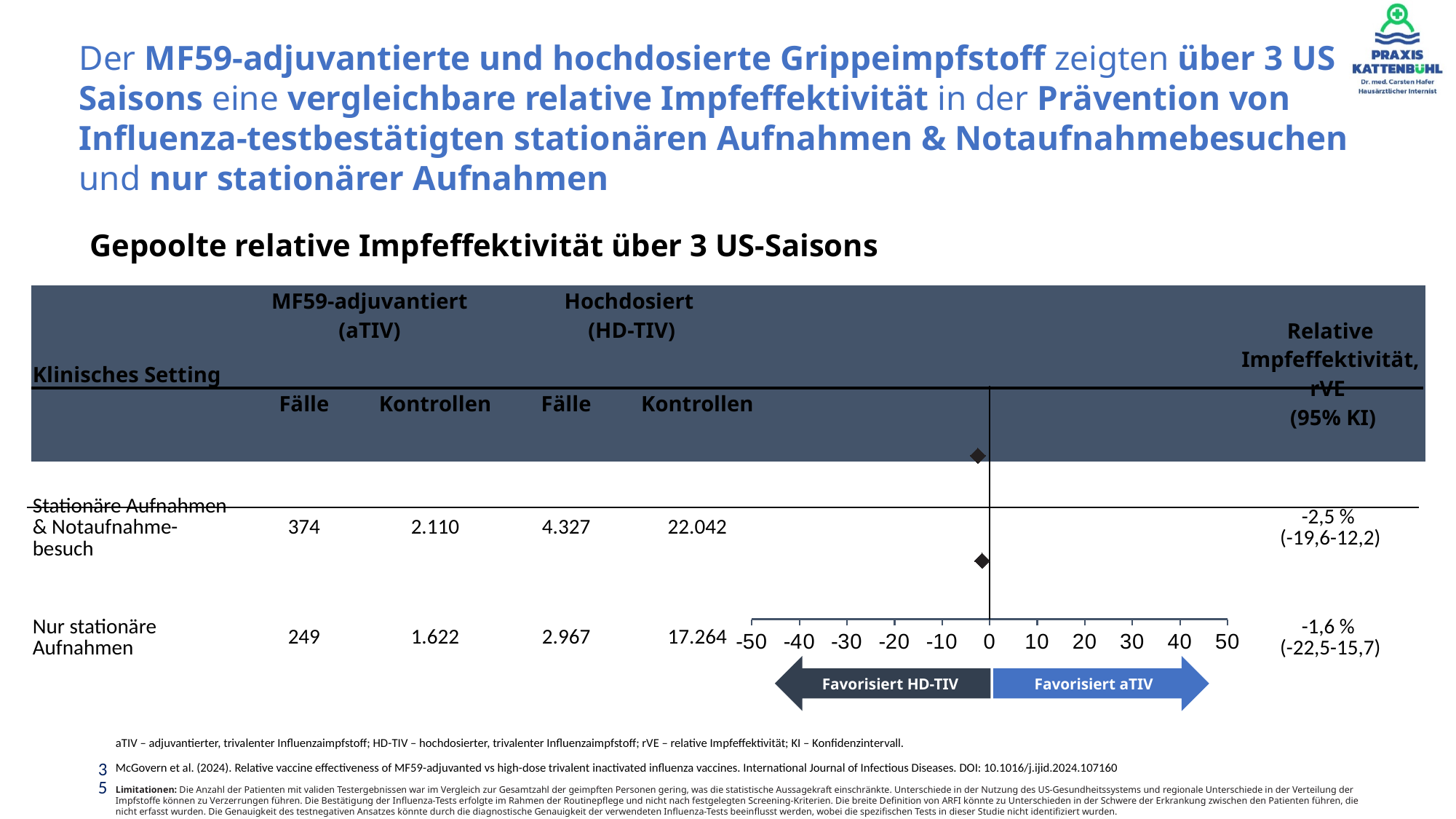
What is the 95% KI printed for 'Stationäre Aufnahmen & Notaufnahmebesuch'? (-19,6-12,2) What is the difference between the rVE values for 'Nur stationäre Aufnahmen' and 'Stationäre Aufnahmen & Notaufnahmebesuch'? 0,9 % Is the rVE value for 'Nur stationäre Aufnahmen' greater or less than 0? less Which rVE value is larger: 'Stationäre Aufnahmen & Notaufnahmebesuch' or 'Nur stationäre Aufnahmen'? Nur stationäre Aufnahmen Which clinical setting has the lower rVE value? Stationäre Aufnahmen & Notaufnahmebesuch What label is shown on the left arrow below the forest plot axis? Favorisiert HD-TIV What is the relative vaccine effectiveness (rVE) shown for 'Stationäre Aufnahmen & Notaufnahmebesuch'? -2,5 % What is the 95% KI printed for 'Nur stationäre Aufnahmen'? (-22,5-15,7) How many aTIV Fälle are listed for 'Nur stationäre Aufnahmen'? 249 How many data points (diamonds) are plotted on the forest plot? 2 What is the relative vaccine effectiveness (rVE) shown for 'Nur stationäre Aufnahmen'? -1,6 % What range does the horizontal axis of the forest plot span? -50 to 50